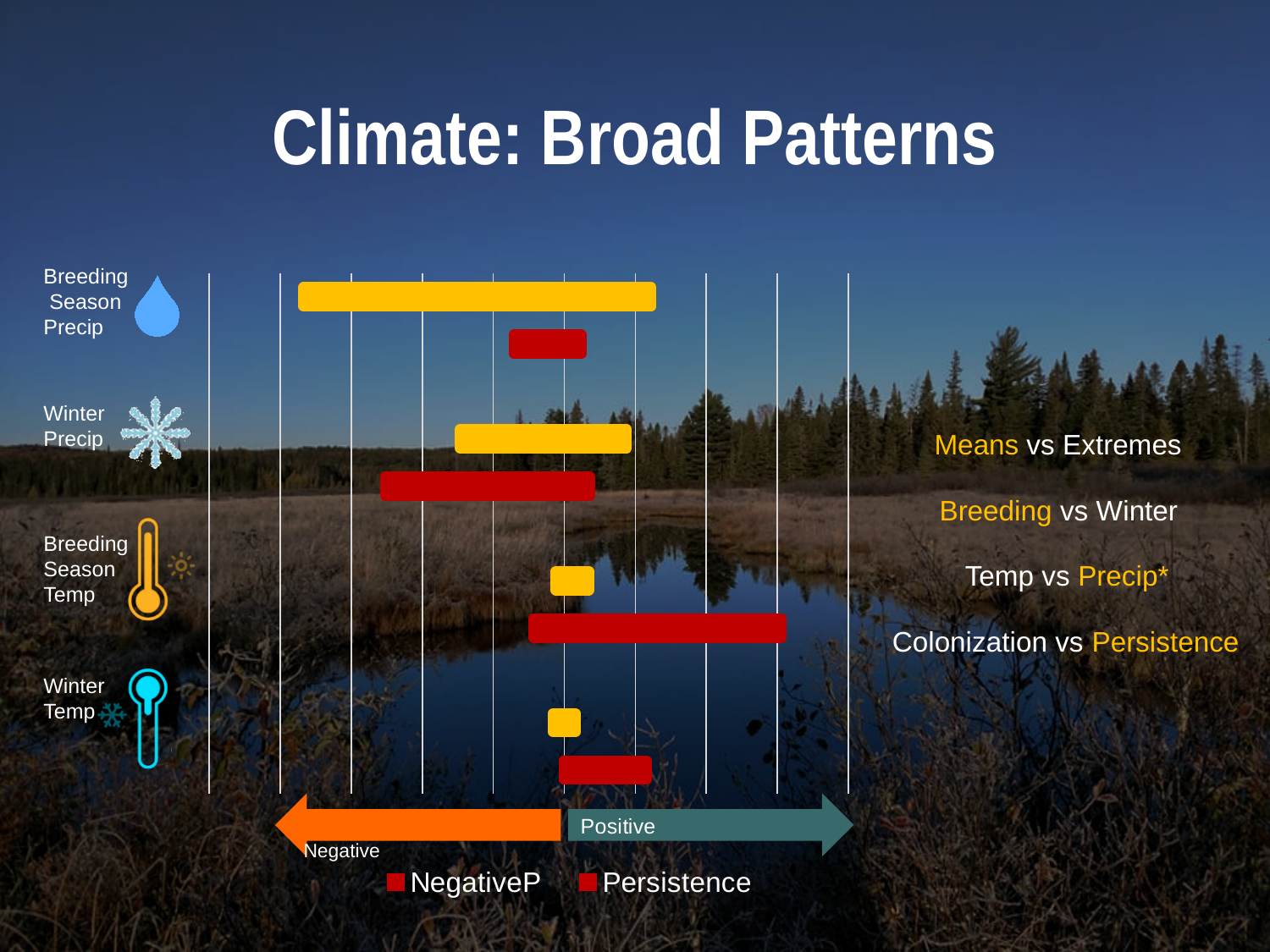
Which is longer, the red bar for Winter Precip or the red bar for Breeding Season Precip? Winter Precip What two direction labels are shown along the horizontal axis of the chart? Negative and Positive Which category has the longest yellow bar? Breeding Season Precip How many series does the chart legend list? 2 What kind of chart is shown on the slide? bar chart What is the title of the slide containing the chart? Climate: Broad Patterns Which category has the longest red bar? Breeding Season Temp How many climate variables (categories) are plotted on the chart? 4 Which is longer, the yellow bar for Breeding Season Precip or the yellow bar for Breeding Season Temp? Breeding Season Precip Which is longer, the yellow bar for Winter Precip or the yellow bar for Winter Temp? Winter Precip